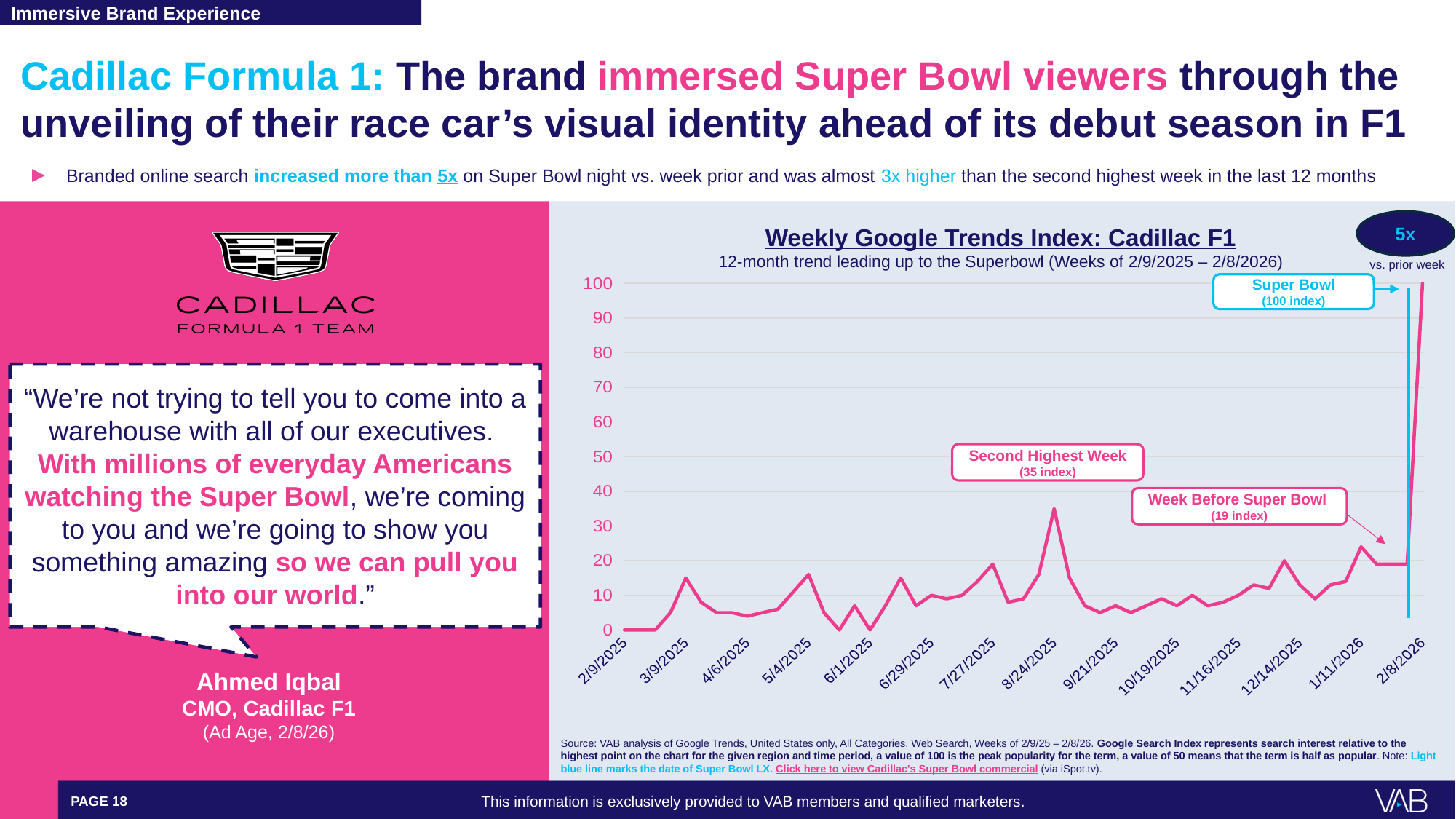
What is the difference between the Super Bowl week index and the Week Before Super Bowl index? 81 How many date labels are shown on the x axis of the chart? 14 What is the index value for the Super Bowl week in the Weekly Google Trends Index chart? 100 index What index value is labeled for the Second Highest Week? 35 index What kind of chart is shown on the slide? Line chart Is the peak value near 1/11/2026 greater or less than 10? greater Is the value for the week of 2/9/2025 greater or less than 10? less What is the title of the chart? Weekly Google Trends Index: Cadillac F1 Which week has the highest value on the chart? Super Bowl week (2/8/2026) Which is larger, the Second Highest Week index or the Week Before Super Bowl index? Second Highest Week What index value is labeled for the Week Before Super Bowl? 19 index What is the difference between the Super Bowl week index and the Second Highest Week index? 65